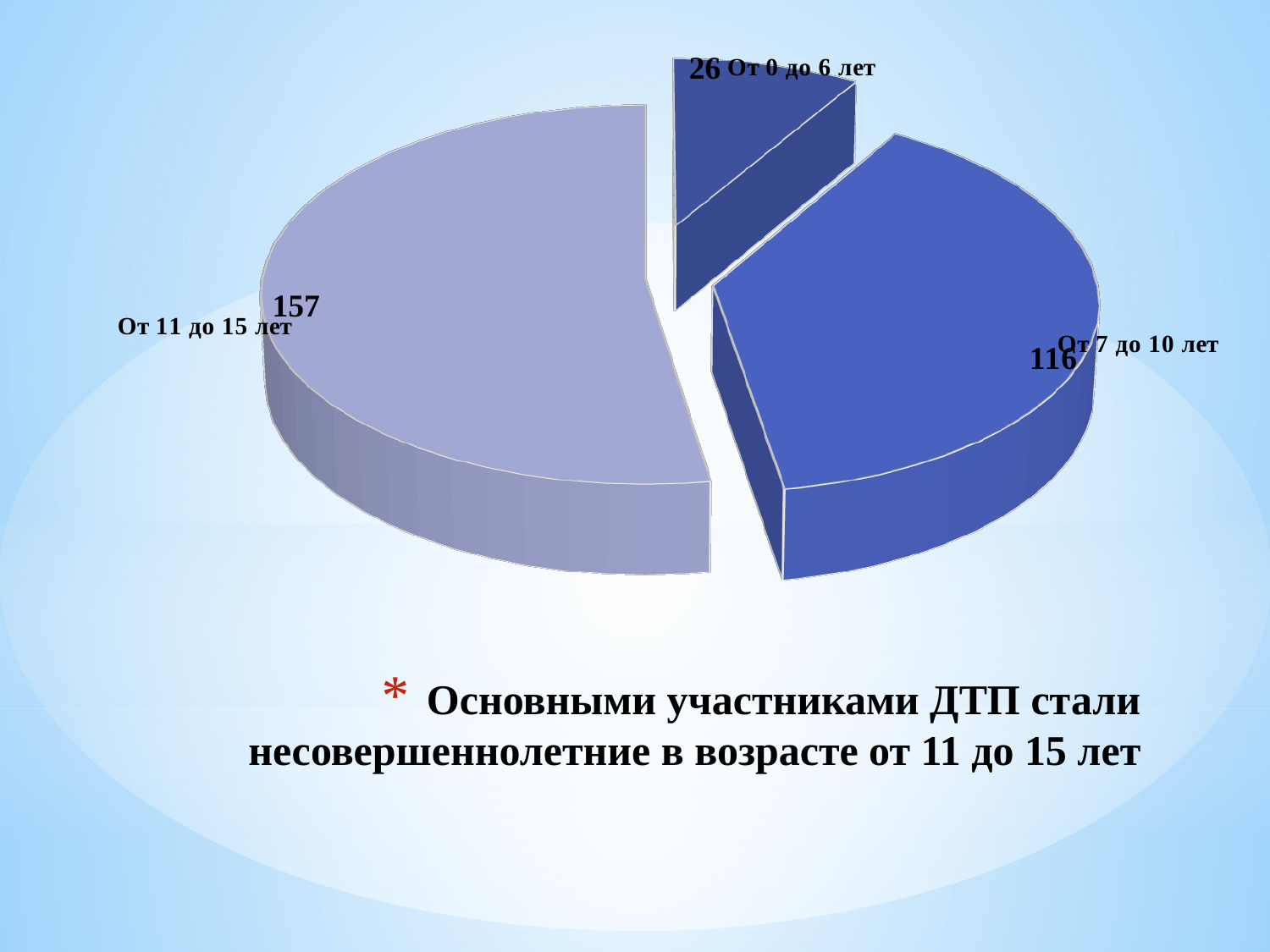
Which age group has the largest slice of the pie? От 11 до 15 лет What value is shown for the slice "От 7 до 10 лет"? 116 What is the difference between the values for "От 11 до 15 лет" and "От 7 до 10 лет"? 41 What is the difference between the values for "От 7 до 10 лет" and "От 0 до 6 лет"? 90 What value is shown for the slice "От 11 до 15 лет"? 157 What value is shown for the slice "От 0 до 6 лет"? 26 Which is larger, the value for "От 7 до 10 лет" or the value for "От 0 до 6 лет"? От 7 до 10 лет What kind of chart is shown on the slide? Pie chart Which age group has the smallest slice of the pie? От 0 до 6 лет How many slices does the pie chart have? 3 Which slice of the pie is drawn in the lightest colour? От 11 до 15 лет What is the total of all three slices in the pie chart? 299